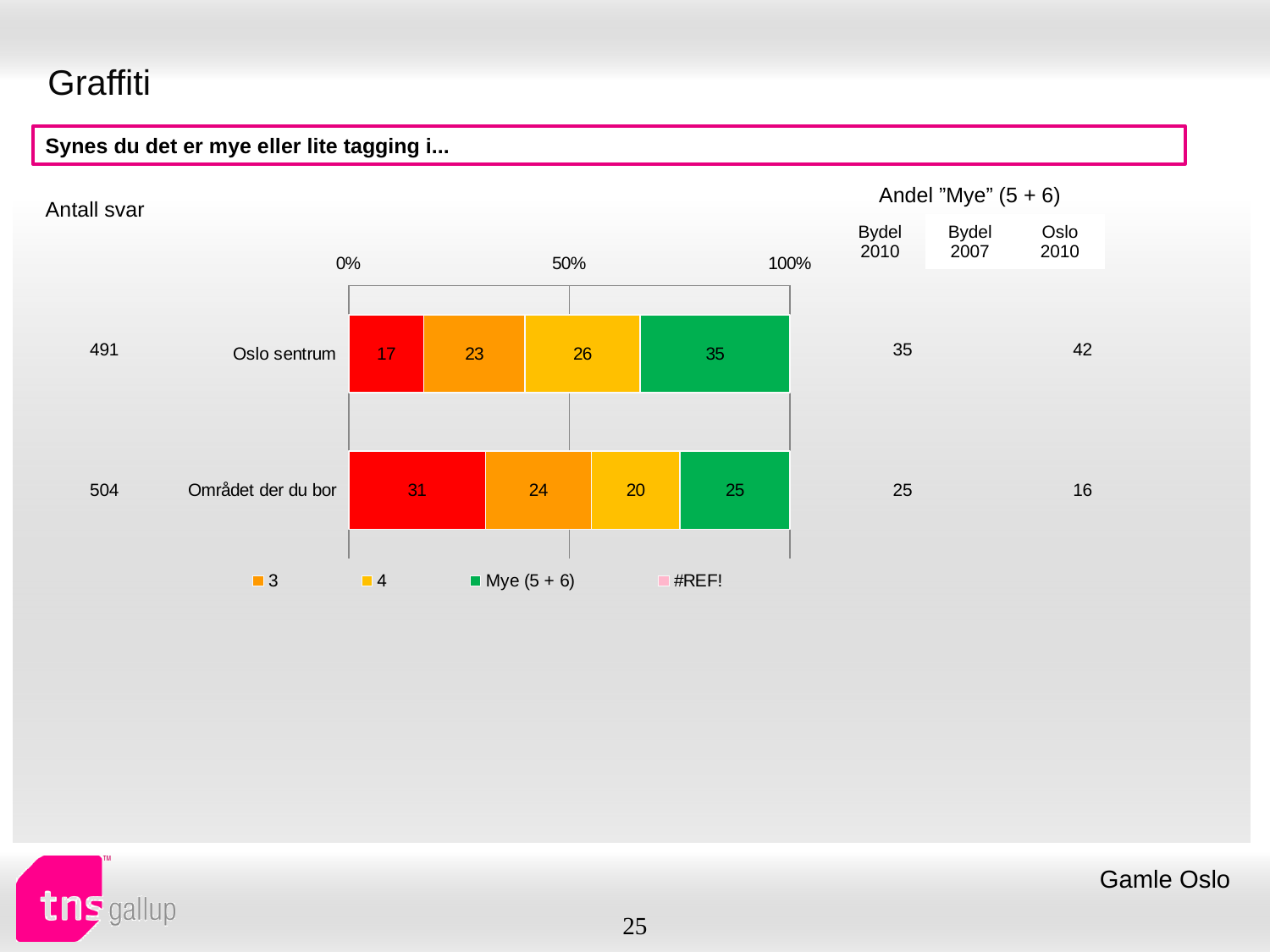
What kind of chart is shown on the slide? Stacked bar chart What is the value of the Mye (5 + 6) segment for Oslo sentrum? 35 What is the value of the series labelled 4 for Området der du bor? 20 What is the value of the Mye (5 + 6) segment for Området der du bor? 25 What is the value of the series labelled 4 for Oslo sentrum? 26 What question text is shown in the box above the chart? Synes du det er mye eller lite tagging i... What is the difference between the Mye (5 + 6) values for Oslo sentrum and Området der du bor? 10 Which category has the larger value for the series labelled 4, Oslo sentrum or Området der du bor? Oslo sentrum What is the value of the series labelled 3 for Oslo sentrum? 23 Which category has the larger Mye (5 + 6) value, Oslo sentrum or Området der du bor? Oslo sentrum What is the total of the stacked bar for Området der du bor? 100 How many categories are shown in the chart? 2